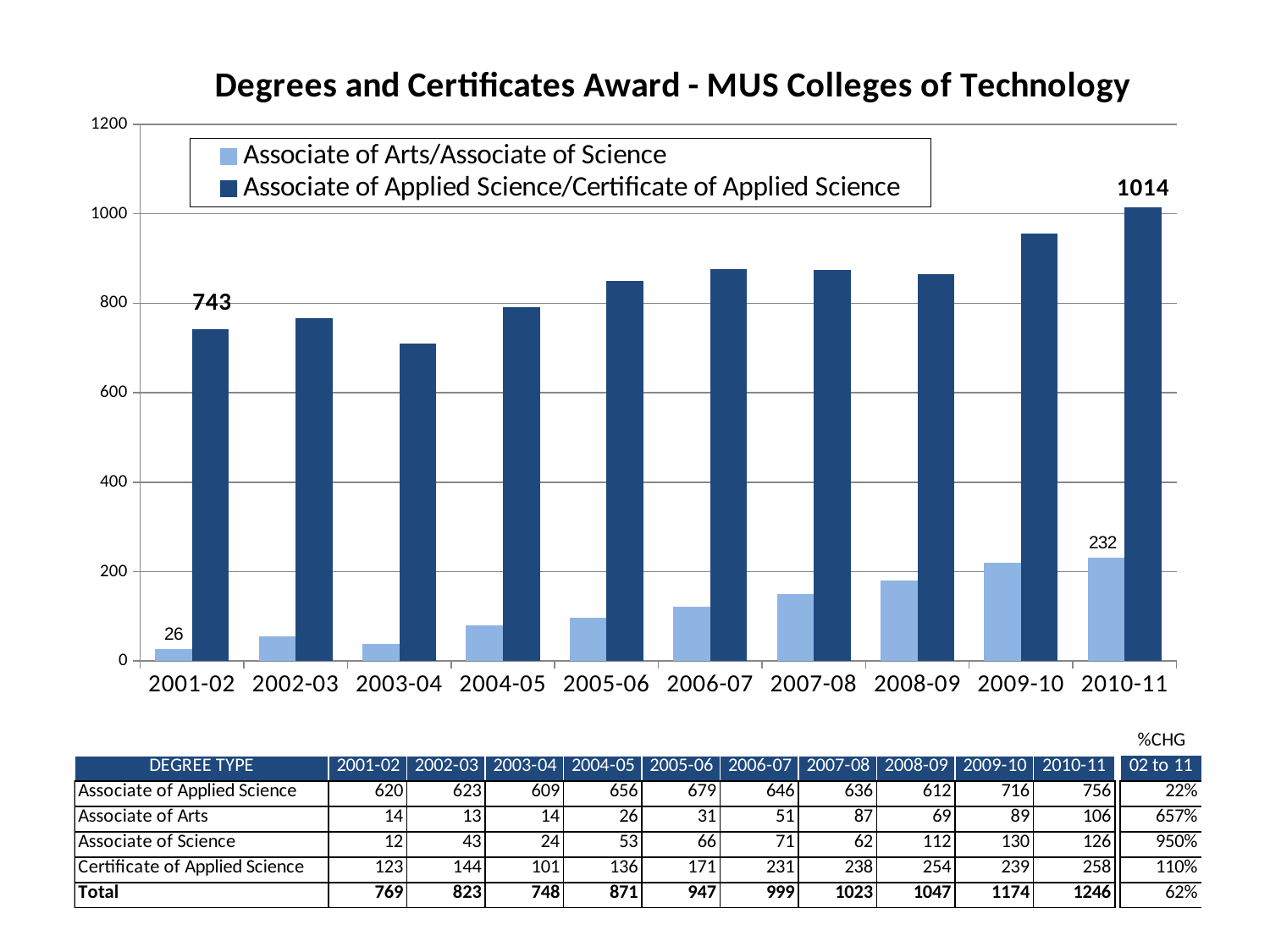
What is the value for Associate of Applied Science/Certificate of Applied Science in 2001-02? 743 By how much did the Associate of Applied Science/Certificate of Applied Science value increase from 2001-02 to 2010-11? 271 In which year is the Associate of Applied Science/Certificate of Applied Science bar the highest? 2010-11 What is the difference between the Associate of Arts/Associate of Science values in 2010-11 and 2001-02? 206 Do the Associate of Arts/Associate of Science values generally rise or fall from 2001-02 to 2010-11? rise What is the value for Associate of Arts/Associate of Science in 2010-11? 232 How many series does the legend list? 2 What is the value for Associate of Applied Science/Certificate of Applied Science in 2010-11? 1014 How many academic years are shown on the x axis of the chart? 10 What is the value for Associate of Arts/Associate of Science in 2001-02? 26 Is the value for Associate of Applied Science/Certificate of Applied Science in 2009-10 greater or less than 800? greater What kind of chart is shown on the slide? bar chart